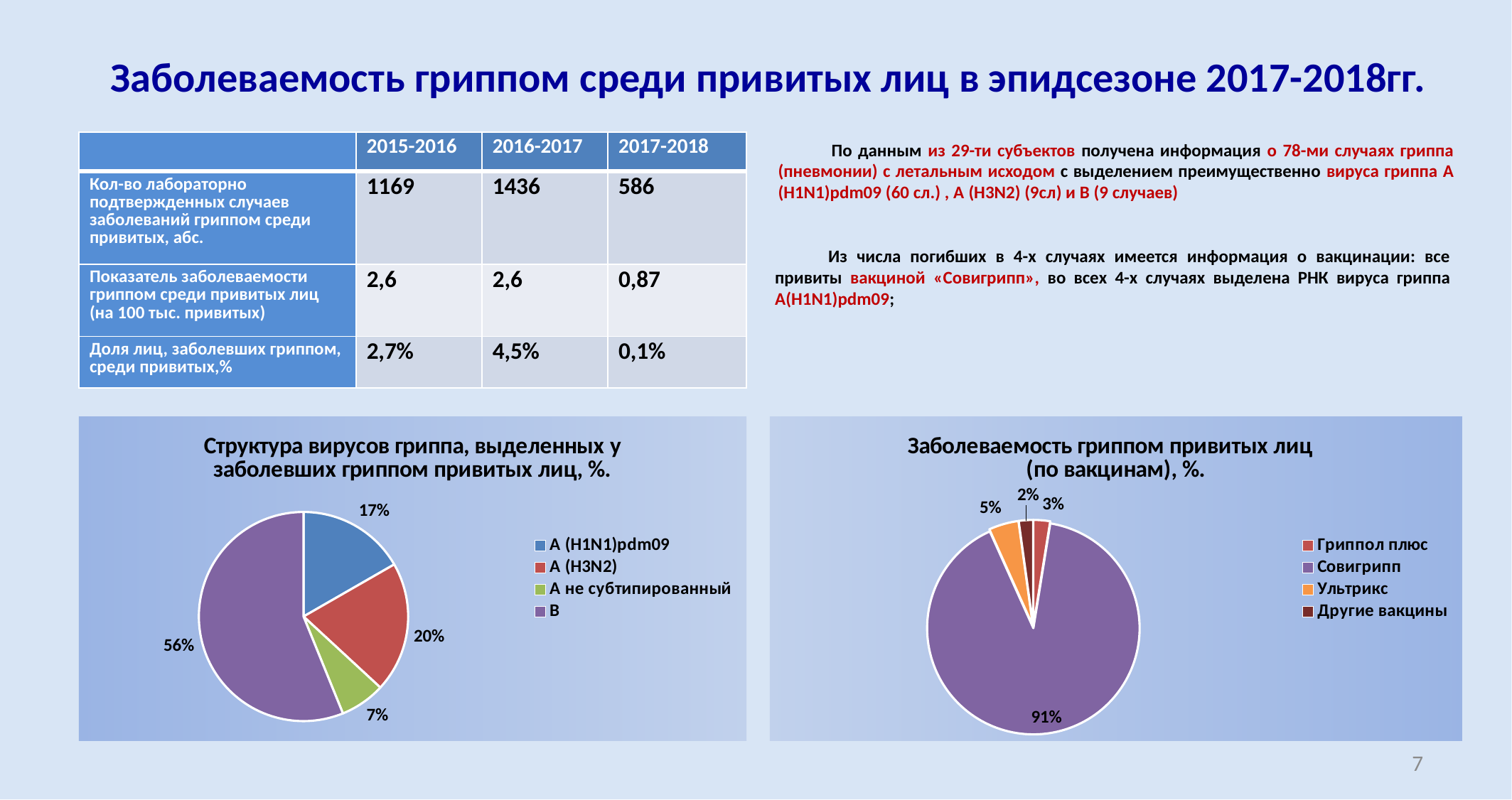
What type of chart is used on the right side of the slide (Заболеваемость гриппом привитых лиц по вакцинам)? Pie chart On the right pie chart (Заболеваемость гриппом привитых лиц по вакцинам), which vaccine has the smallest share? Другие вакцины On the left pie chart (Структура вирусов гриппа), which virus has the smallest share? A не субтипированный On the left pie chart (Структура вирусов гриппа), what share is labelled for A (H1N1)pdm09? 17% On the right pie chart (Заболеваемость гриппом привитых лиц по вакцинам), what share is labelled for Ультрикс? 5% On the left pie chart (Структура вирусов гриппа), which virus has the largest share? B On the left pie chart (Структура вирусов гриппа), what share is labelled for A не субтипированный? 7% On the left pie chart (Структура вирусов гриппа), how many categories does the legend list? 4 On the left pie chart (Структура вирусов гриппа), what share is labelled for A (H3N2)? 20% On the right pie chart (Заболеваемость гриппом привитых лиц по вакцинам), which is larger: Гриппол плюс or Ультрикс? Ультрикс On the left pie chart (Структура вирусов гриппа), what is the difference between the shares of B and A (H3N2)? 36% On the right pie chart (Заболеваемость гриппом привитых лиц по вакцинам), what share is labelled for Совигрипп? 91%